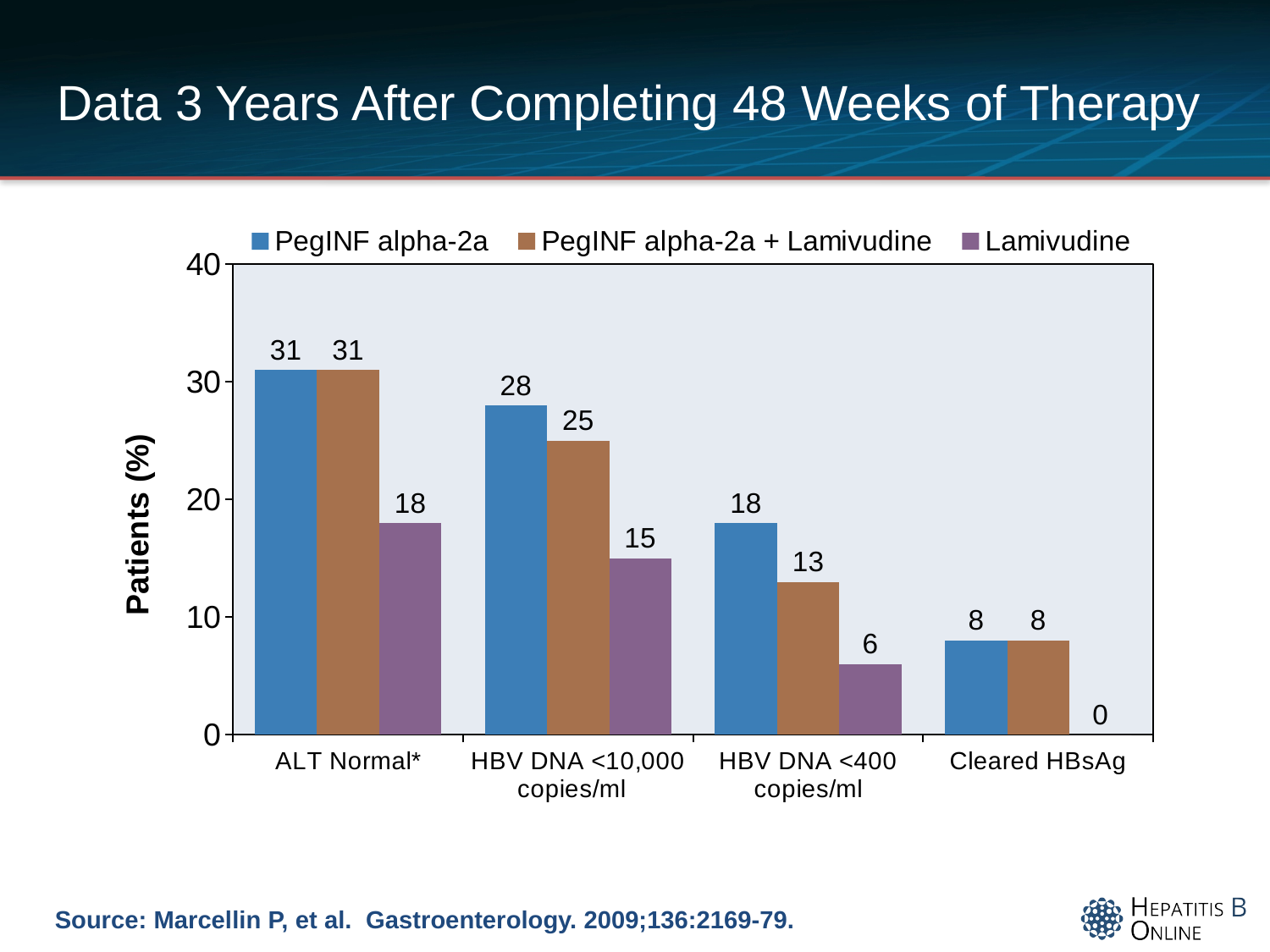
Which category has the highest value for the PegINF alpha-2a series? ALT Normal* Which category has the lowest value for the Lamivudine series? Cleared HBsAg How many series does the legend list? 3 What is the value for Lamivudine in the HBV DNA <400 copies/ml category? 6 What is the value for Lamivudine in the Cleared HBsAg category? 0 What is the difference between the PegINF alpha-2a and Lamivudine values in the HBV DNA <10,000 copies/ml category? 13 How many categories are shown on the x axis? 4 What is the value for PegINF alpha-2a + Lamivudine in the ALT Normal* category? 31 What percentage of patients in the PegINF alpha-2a group had HBV DNA <10,000 copies/ml? 28 In the HBV DNA <400 copies/ml category, which is larger: PegINF alpha-2a or PegINF alpha-2a + Lamivudine? PegINF alpha-2a What is the label of the y axis? Patients (%) What kind of chart is shown on the slide? Bar chart